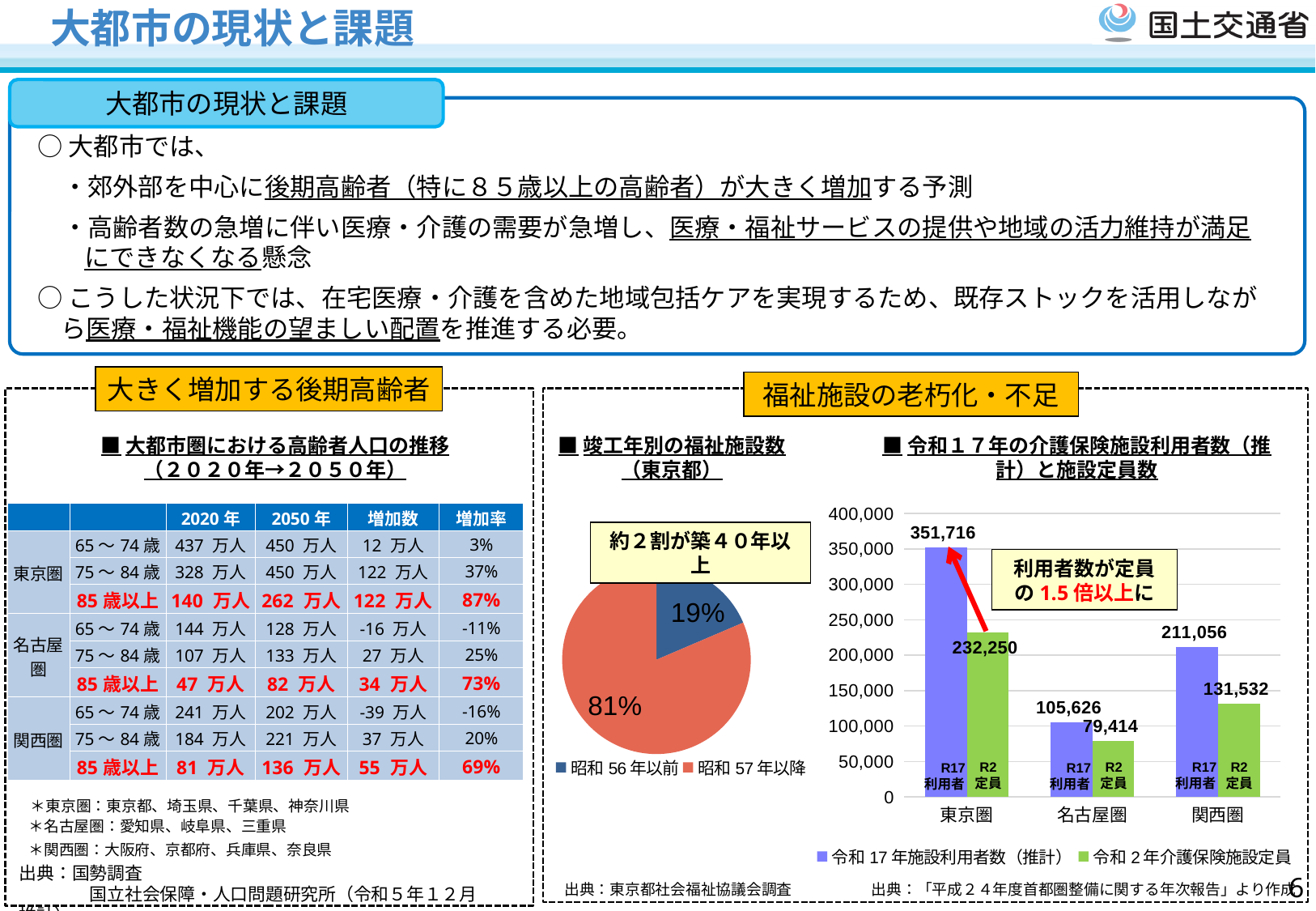
In the bar chart titled 令和17年の介護保険施設利用者数（推計）と施設定員数, how many series does the legend list? 2 What kind of chart is the one titled 令和17年の介護保険施設利用者数（推計）と施設定員数? bar chart In the pie chart titled 竣工年別の福祉施設数（東京都）, which slice is larger, 昭和56年以前 or 昭和57年以降? 昭和57年以降 In the pie chart titled 竣工年別の福祉施設数（東京都）, how many slices are there? 2 In the bar chart titled 令和17年の介護保険施設利用者数（推計）と施設定員数, which region has the lowest R2定員 value? 名古屋圏 In the pie chart titled 竣工年別の福祉施設数（東京都）, what share of facilities is 昭和56年以前? 19% In the bar chart titled 令和17年の介護保険施設利用者数（推計）と施設定員数, what is the difference between R17利用者 and R2定員 for 東京圏? 119,466 In the bar chart titled 令和17年の介護保険施設利用者数（推計）と施設定員数, what is the value of R2定員 for 関西圏? 131,532 In the pie chart titled 竣工年別の福祉施設数（東京都）, what share of facilities is 昭和57年以降? 81% In the bar chart titled 令和17年の介護保険施設利用者数（推計）と施設定員数, what is the value of R17利用者 for 東京圏? 351,716 In the bar chart titled 令和17年の介護保険施設利用者数（推計）と施設定員数, what is the value of R2定員 for 名古屋圏? 79,414 In the bar chart titled 令和17年の介護保険施設利用者数（推計）と施設定員数, which region has the highest R17利用者 value? 東京圏